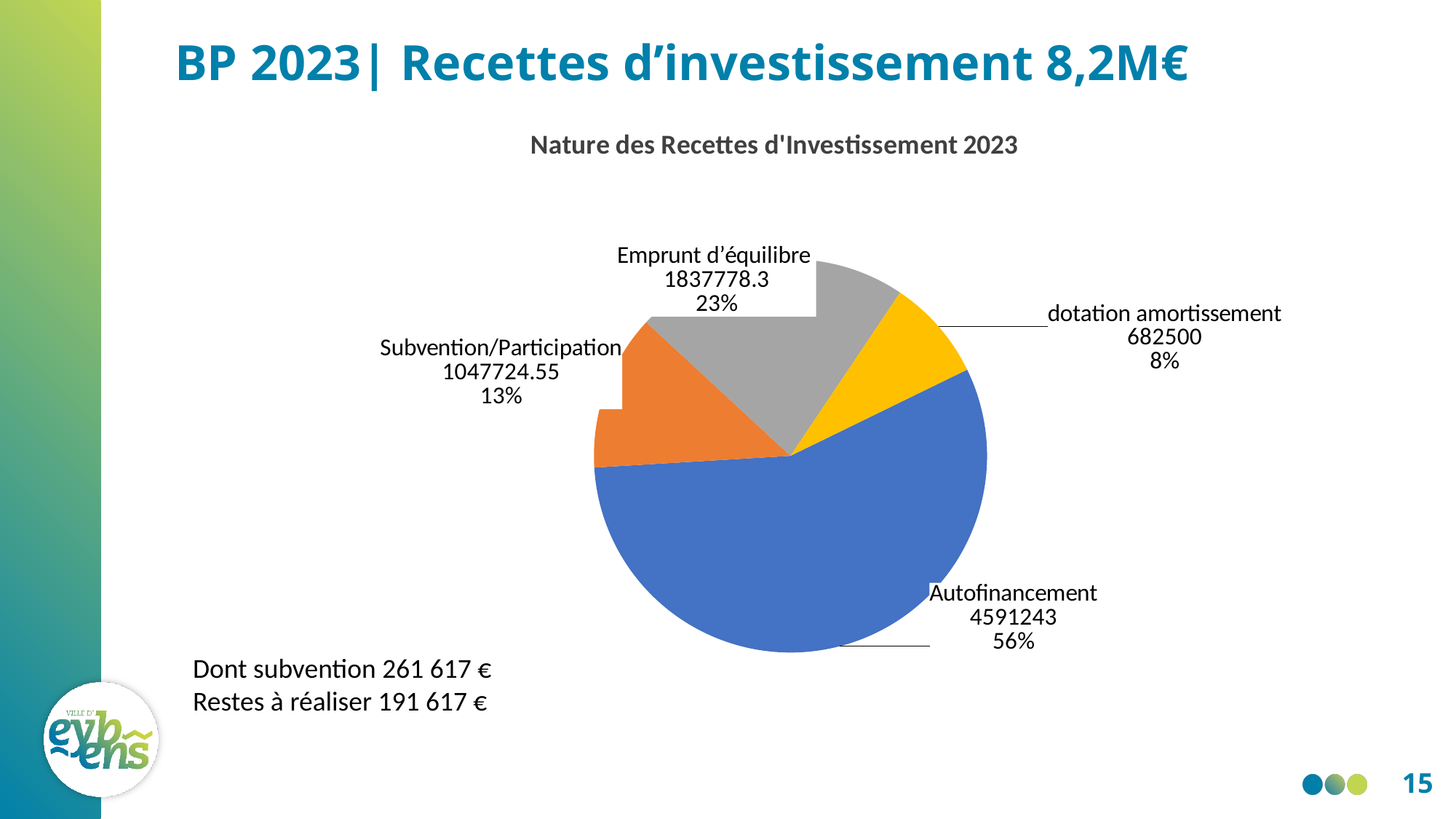
What is the value for dotation amortissement? 682500 Which category has the smallest slice? dotation amortissement What share of the pie does dotation amortissement represent? 8% What is the value for Emprunt d'équilibre? 1837778.3 What is the value for Subvention/Participation? 1047724.55 What share of the pie does Autofinancement represent? 56% Which is larger, Emprunt d'équilibre or Subvention/Participation? Emprunt d'équilibre What is the title of the chart? Nature des Recettes d'Investissement 2023 Which category has the largest slice? Autofinancement What is the value for Autofinancement? 4591243 What type of chart is shown on the slide? pie chart How many slices does the pie chart have? 4